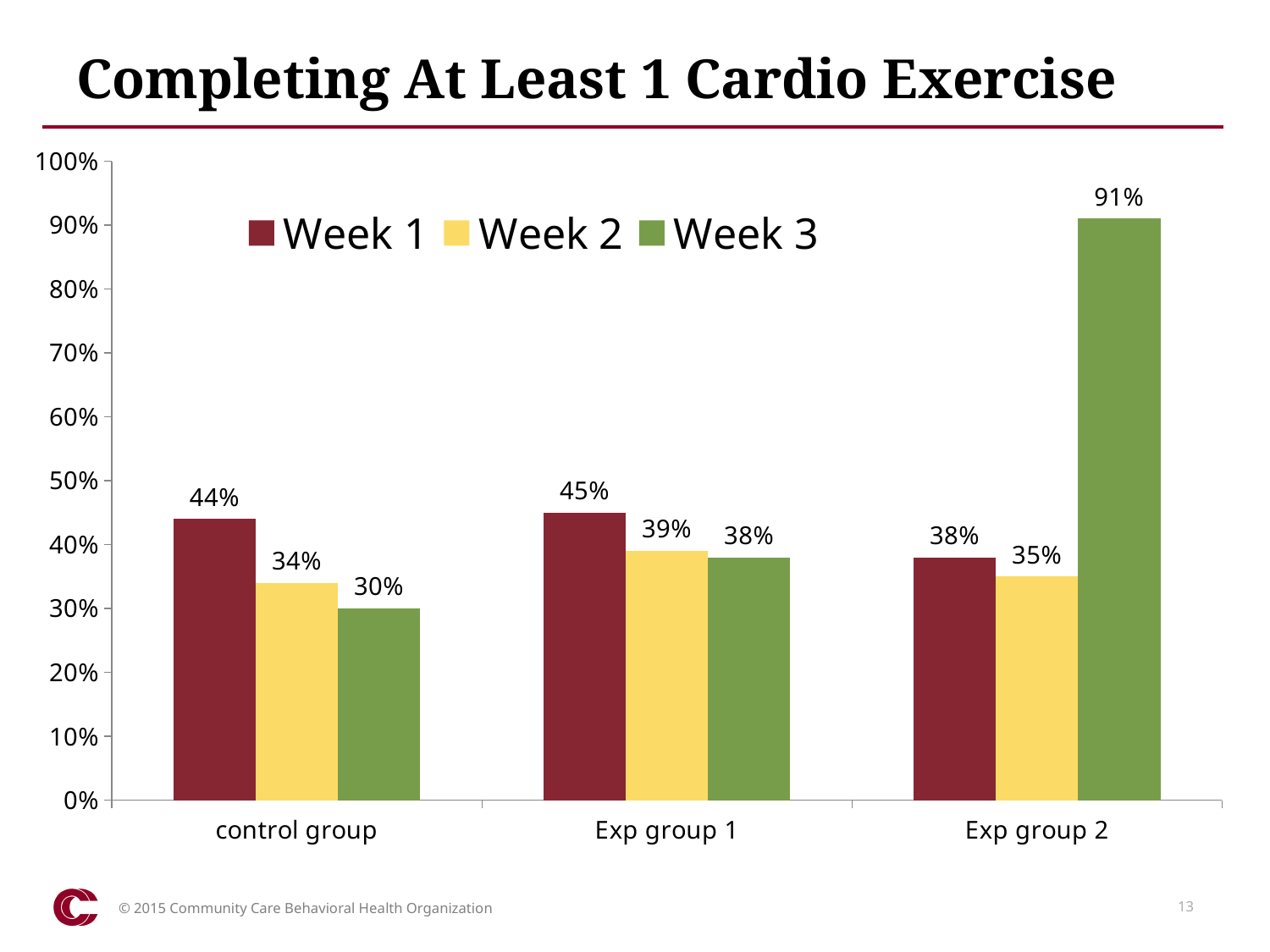
What is the Week 1 value for the control group? 44% What kind of chart is shown on the slide? bar chart What is the difference between the Week 3 and Week 1 values for Exp group 2? 53% How many series does the legend list? 3 How many groups are shown on the x axis? 3 Which is larger for the control group, the Week 1 value or the Week 2 value? Week 1 Which group has the lowest Week 3 value? control group Do the values for the control group rise or fall from Week 1 to Week 3? fall Is the Week 3 value for Exp group 2 greater or less than 80%? greater Which group has the highest Week 3 value? Exp group 2 What is the Week 2 value for Exp group 1? 39% What is the Week 3 value for Exp group 2? 91%